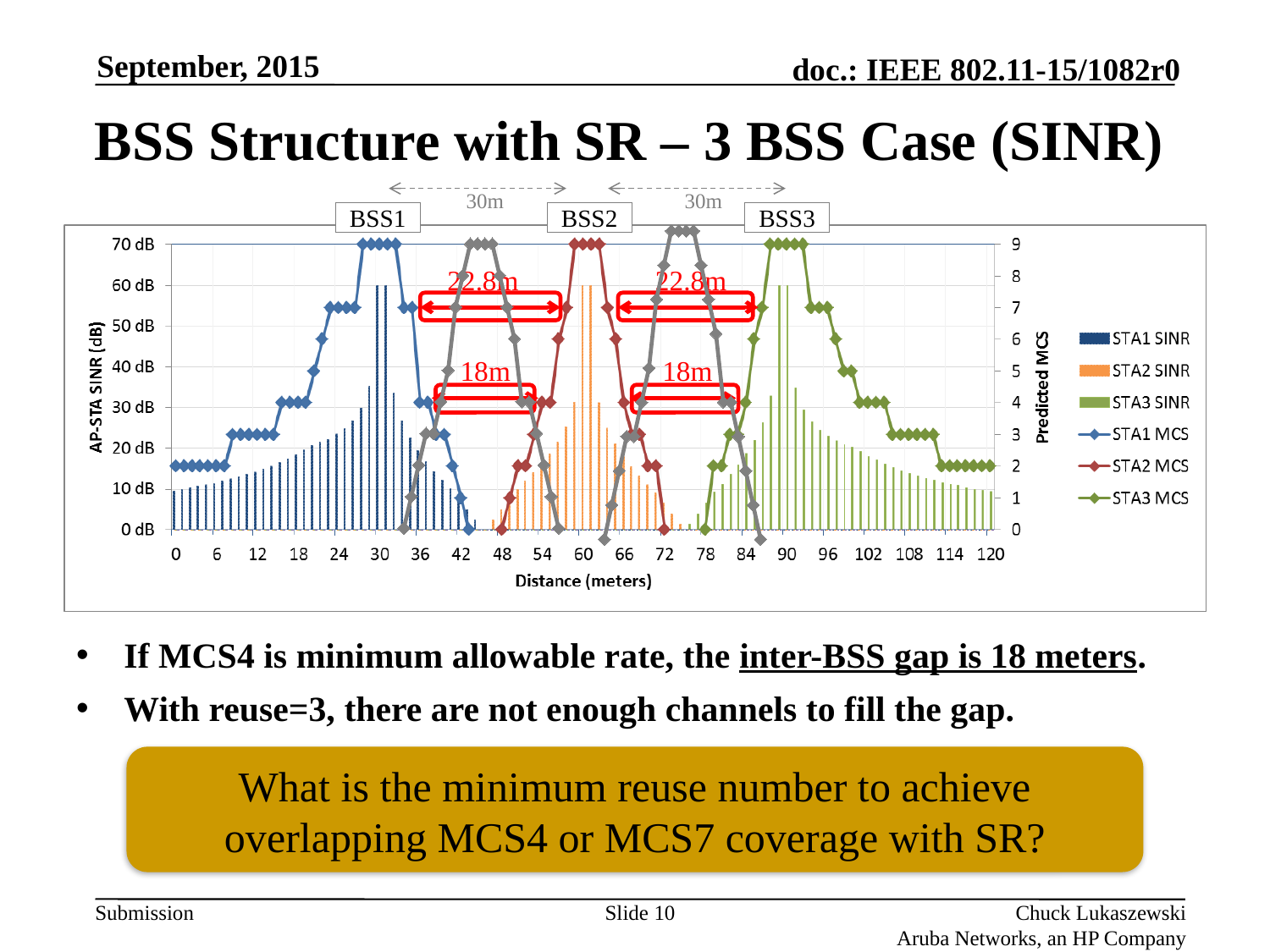
Is the STA1 SINR value at 30 meters greater or less than 50 dB? greater What is the title of the x axis of the chart? Distance (meters) Is the STA3 SINR value at 120 meters greater or less than 20 dB? less What is the title of the right-hand vertical axis of the chart? Predicted MCS What is the STA1 MCS value at a distance of 12 meters? 3 What kind of chart is shown on the slide? A combination chart of bars and lines What is the STA2 MCS value at a distance of 60 meters? 9 What is the STA1 MCS value at a distance of 30 meters? 9 How many series does the chart legend list? 6 What is the STA1 MCS value at a distance of 0 meters? 2 What is the STA3 MCS value at a distance of 120 meters? 2 Which is larger, the STA1 MCS value at 12 meters or at 24 meters? 24 meters